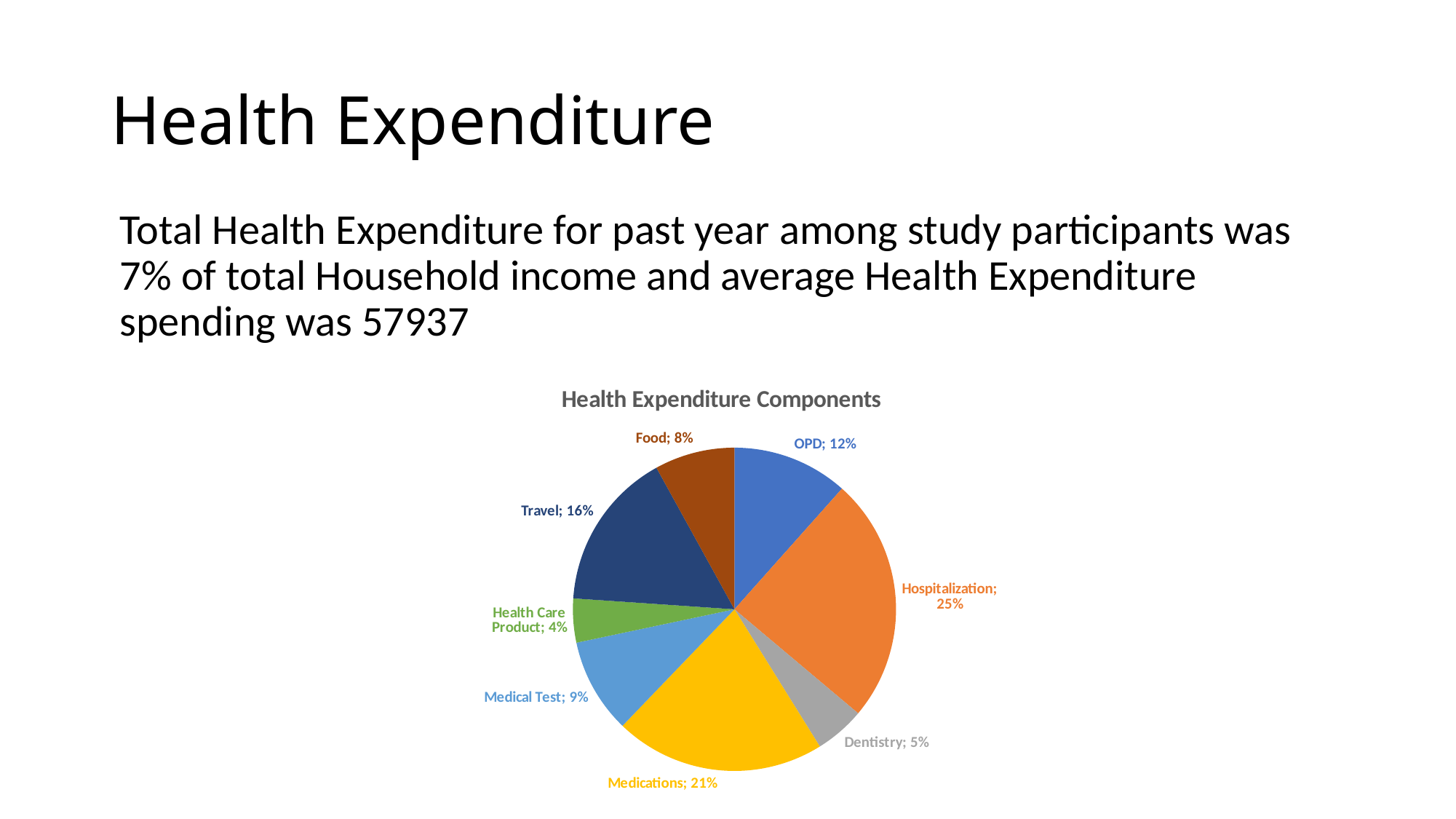
What share of health expenditure is Travel? 16% What is the combined share of Dentistry and Food? 13% What kind of chart is shown on the slide? Pie chart What share of health expenditure is Health Care Product? 4% What share of health expenditure is Hospitalization? 25% How many components are shown in the pie chart? 8 Which component has the largest share of health expenditure? Hospitalization What is the difference between the Medications share and the Medical Test share? 12% What share of health expenditure is Medications? 21% Which is larger, the share for OPD or the share for Food? OPD What is the title of the chart? Health Expenditure Components Which component has the smallest share of health expenditure? Health Care Product